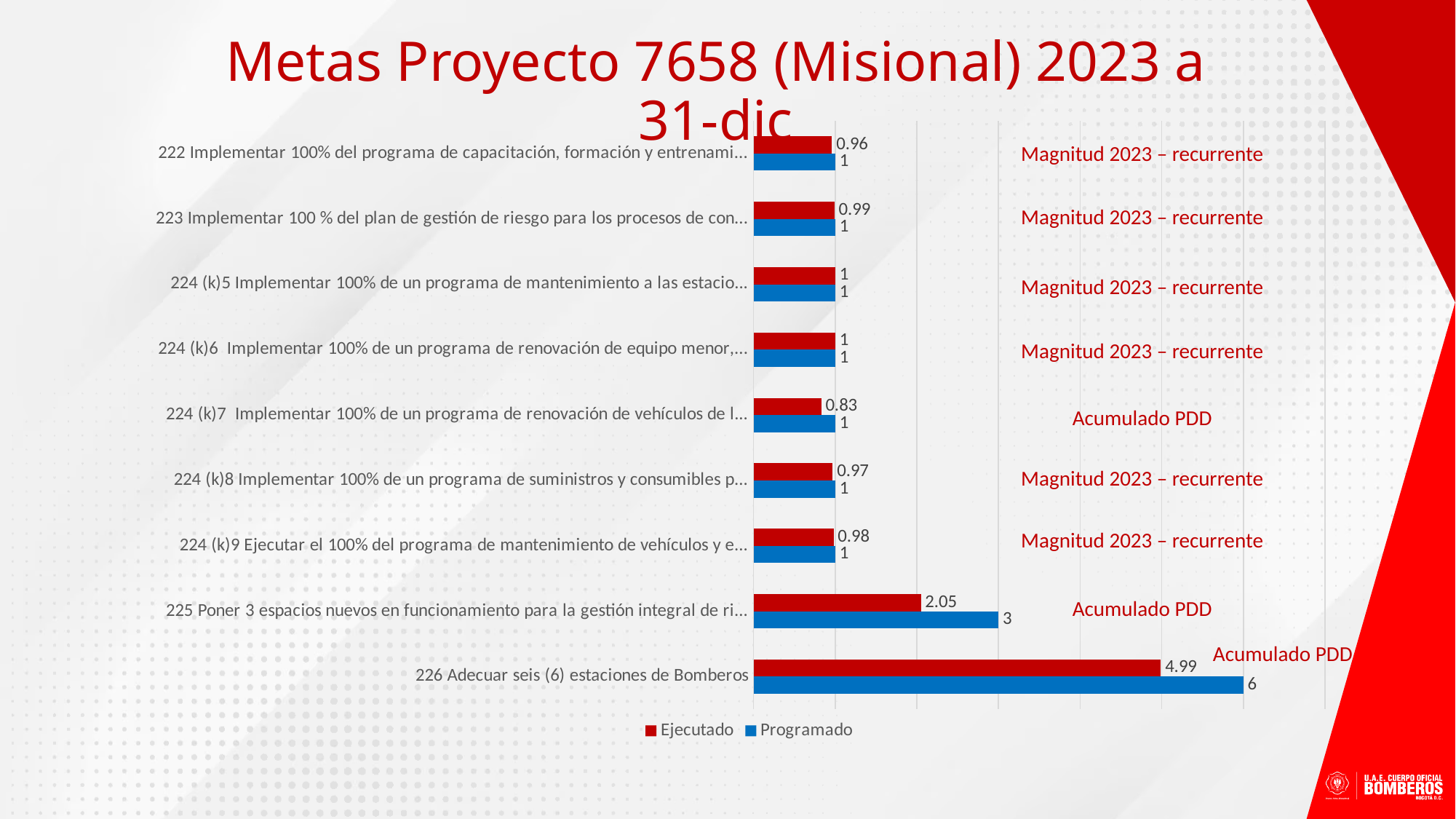
Which category has the lowest Ejecutado value? 224 (k)7 Implementar 100% de un programa de renovación de vehículos de l... What is the Ejecutado value for "224 (k)7 Implementar 100% de un programa de renovación de vehículos de l..."? 0.83 What type of chart is shown on the slide? Bar chart What is the Ejecutado value for "222 Implementar 100% del programa de capacitación, formación y entrenami..."? 0.96 What is the difference between the Programado and Ejecutado values for "225 Poner 3 espacios nuevos en funcionamiento para la gestión integral de ri..."? 0.95 How many categories are shown in the chart? 9 Which is larger for "224 (k)8 Implementar 100% de un programa de suministros y consumibles p...": the Ejecutado value or the Programado value? Programado What is the difference between the Programado and Ejecutado values for "226 Adecuar seis (6) estaciones de Bomberos"? 1.01 How many series does the legend list? 2 What is the Ejecutado value for "226 Adecuar seis (6) estaciones de Bomberos"? 4.99 What is the Programado value for "225 Poner 3 espacios nuevos en funcionamiento para la gestión integral de ri..."? 3 Which category has the highest Programado value? 226 Adecuar seis (6) estaciones de Bomberos